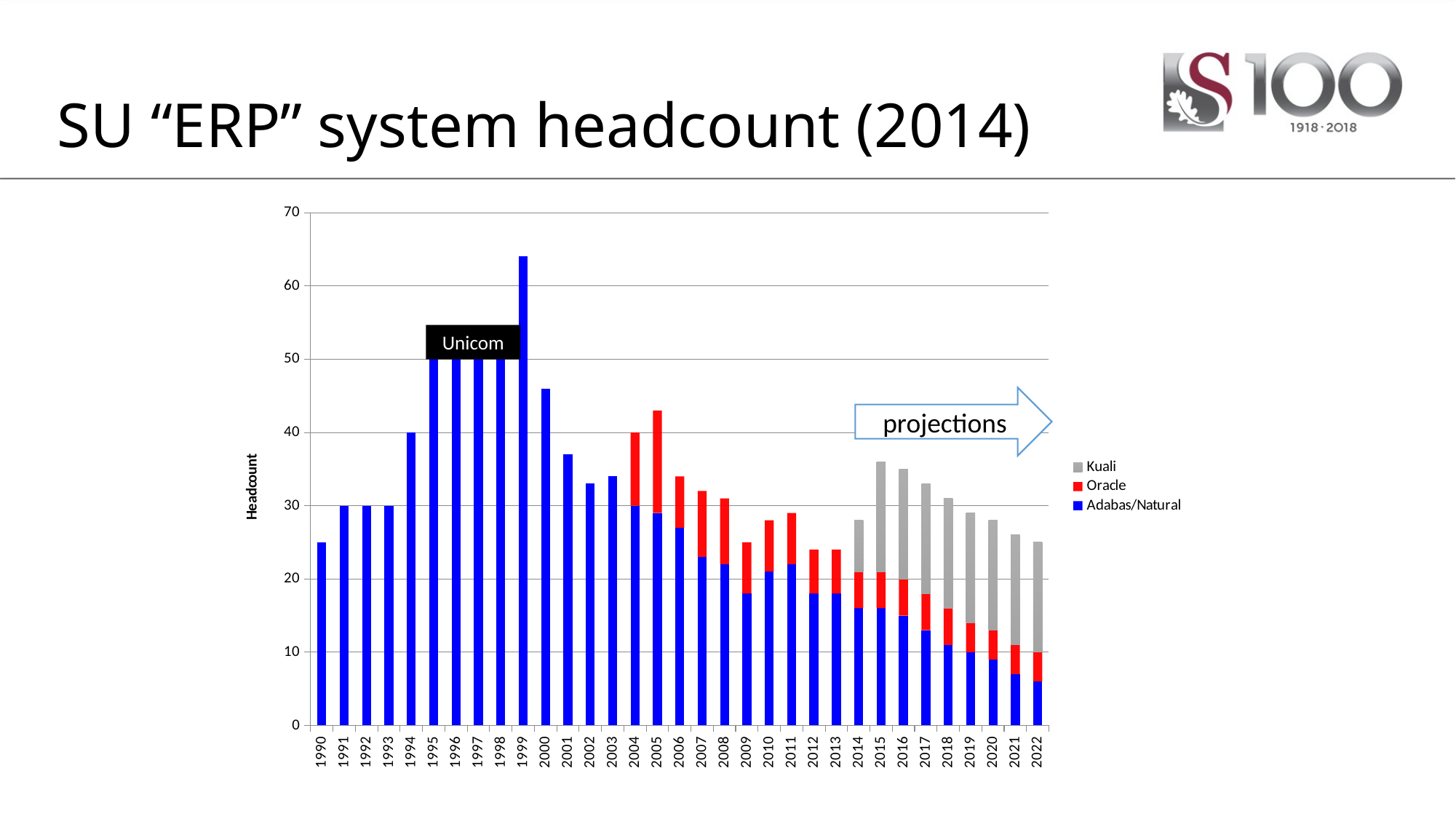
What is the label on the vertical axis? Headcount What kind of chart is shown on the slide? Stacked bar chart Which year has the highest headcount? 1999 Is the headcount for 1999 greater or less than 60? greater Is the headcount for 1990 greater or less than 30? less Do the total headcounts rise or fall from 2015 to 2022? fall Which year has the larger total headcount, 1999 or 2000? 1999 How many years are shown along the x axis? 33 What is the headcount for 1994? 40 Which series are listed in the legend? Kuali, Oracle, Adabas/Natural How many series does the legend list? 3 What is the headcount for 1991? 30